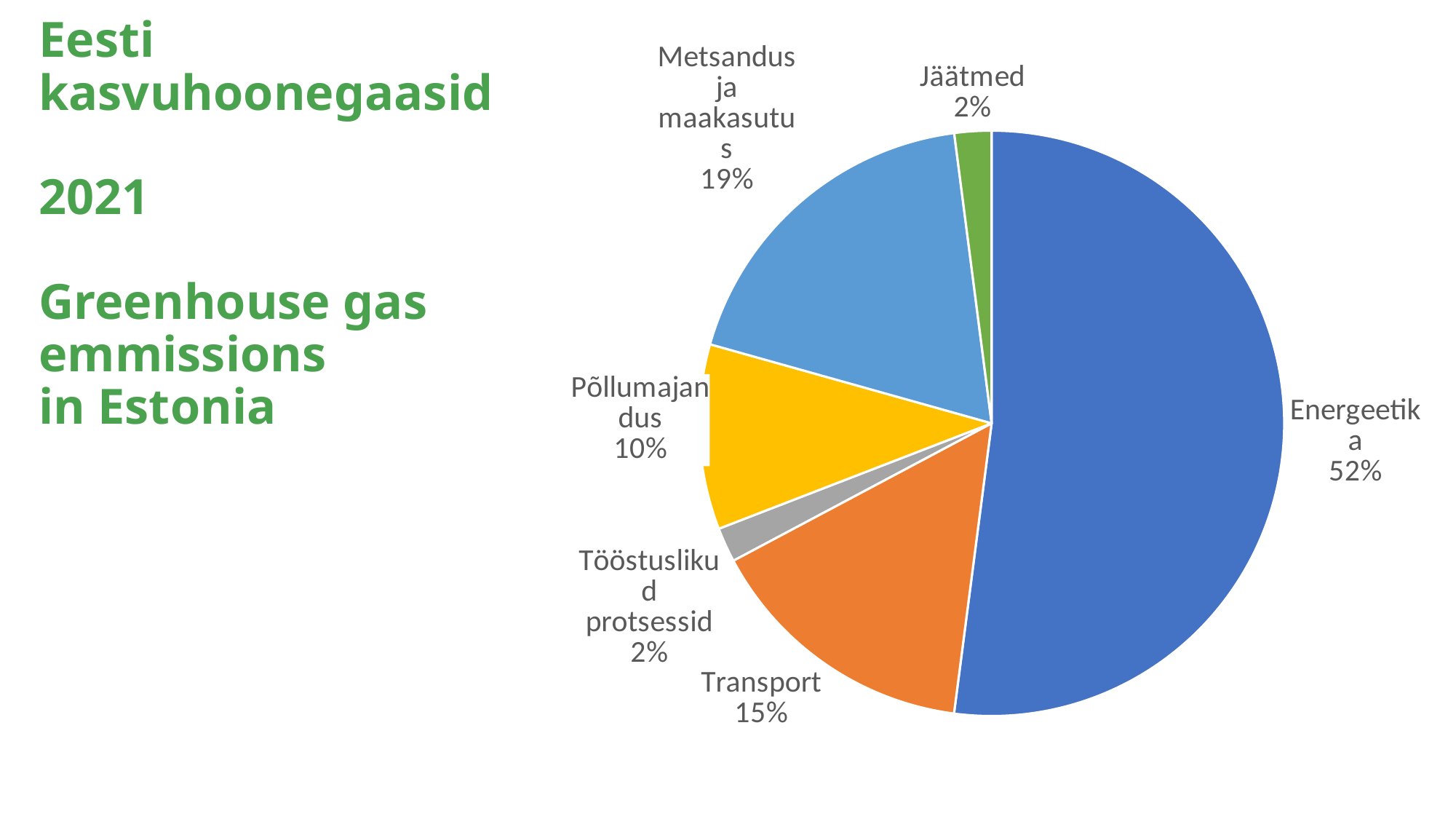
What colour is the Energeetika slice? Blue What is the difference between the shares of Energeetika and Transport? 37% How many slices does the pie chart have? 6 What is the value shown for Jäätmed? 2% What is the value shown for Metsandus ja maakasutus? 19% What is the value shown for Põllumajandus? 10% Which is larger, the share for Transport or the share for Põllumajandus? Transport What is the difference between the shares of Metsandus ja maakasutus and Põllumajandus? 9% Which category has the largest slice of the pie? Energeetika What kind of chart is shown on the slide? Pie chart What share of the pie does Energeetika account for? 52% What is the value shown for Transport? 15%